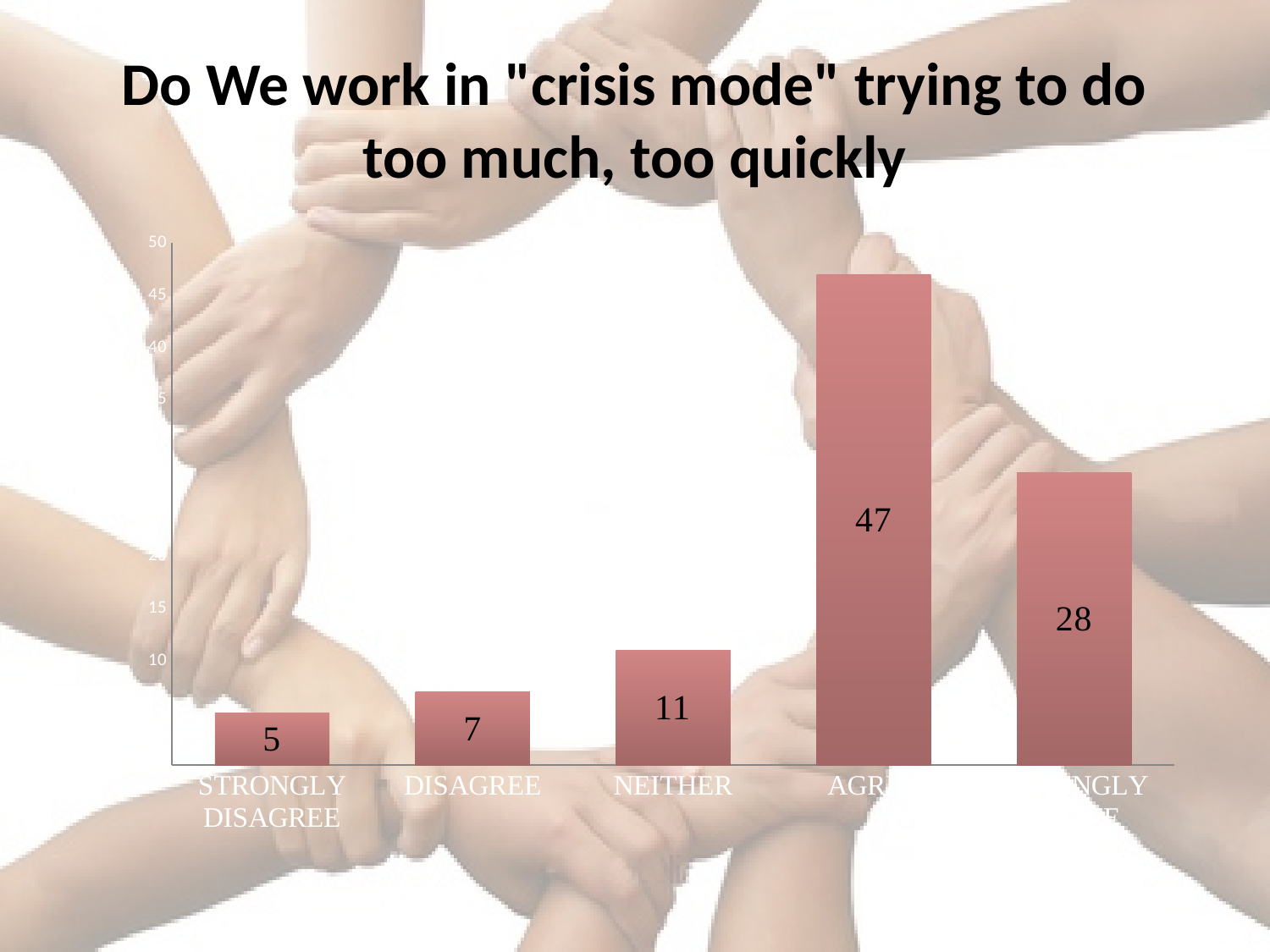
How many bars are shown on the chart? 5 Which category has the lowest value? STRONGLY DISAGREE What is the highest value shown on the chart? 47 What kind of chart is shown on the slide? bar chart What is the value for DISAGREE? 7 What is the value of the tallest bar, the fourth from the left? 47 What is the value for NEITHER? 11 What is the difference between the tallest bar and the rightmost bar? 19 What is the value of the rightmost bar? 28 What is the value for STRONGLY DISAGREE? 5 What is the difference between the value for NEITHER and the value for DISAGREE? 4 Which is larger, the value for DISAGREE or the value for NEITHER? NEITHER